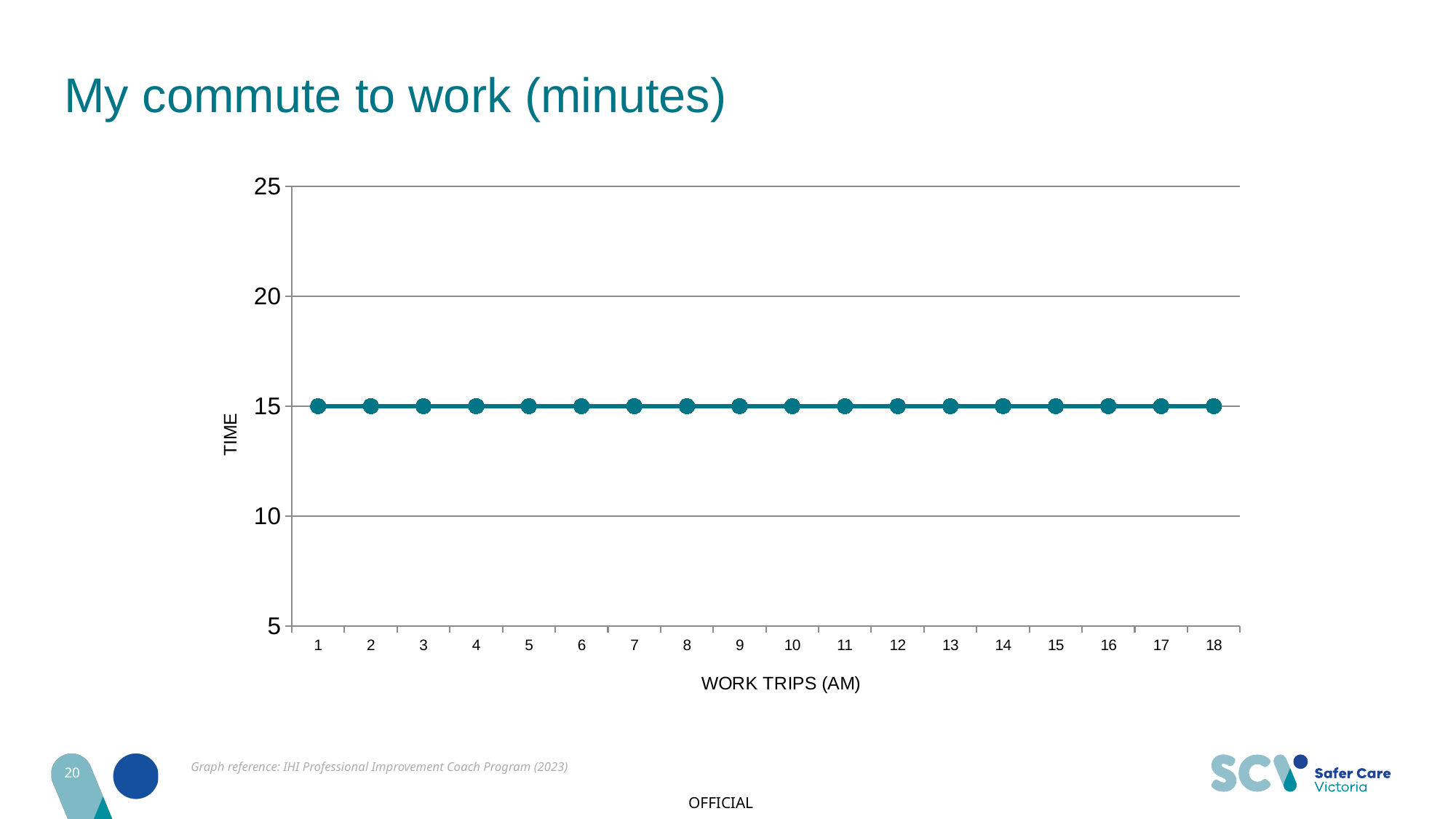
Is the value for work trip 12 greater or less than 20? less What is the commute time for work trip 1? 15 What is the label of the y axis? TIME What kind of chart is shown on the slide? line chart What is the commute time for work trip 10? 15 Is the value for work trip 5 greater or less than 10? greater What is the difference between the commute time for work trip 3 and work trip 15? 0 What is the label of the x axis? WORK TRIPS (AM) What is the commute time for work trip 18? 15 How many work trips are plotted on the x axis? 18 Do the commute times rise, fall, or stay flat across the work trips? stay flat